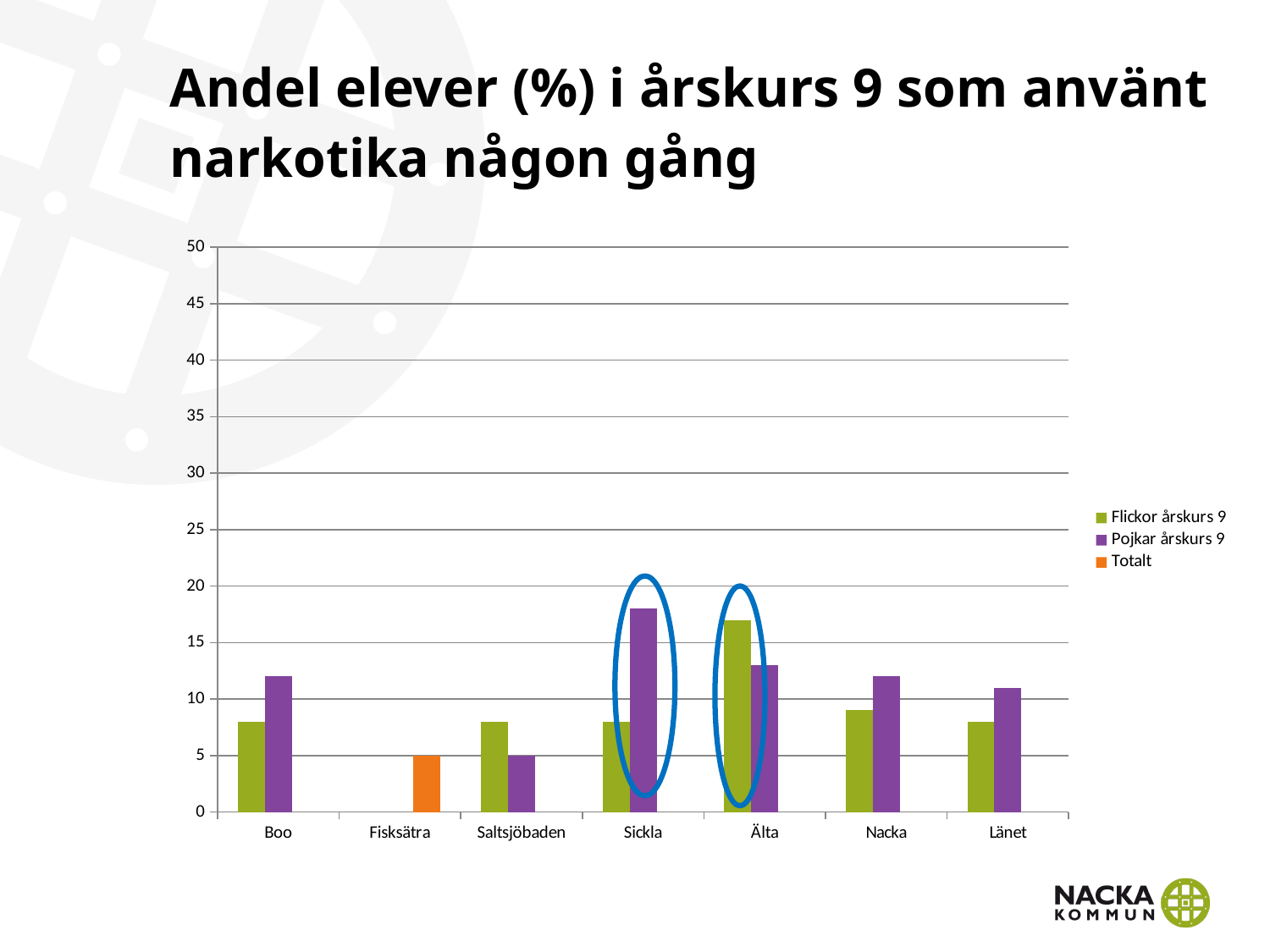
How many categories are shown on the x axis? 7 In Sickla, which is larger: Flickor årskurs 9 or Pojkar årskurs 9? Pojkar årskurs 9 Which category has the highest value for Flickor årskurs 9? Älta Is the value for Pojkar årskurs 9 in Sickla greater or less than 15? greater Is the value for Flickor årskurs 9 in Boo greater or less than 10? less Which category has the lowest value for Pojkar årskurs 9? Saltsjöbaden Which category shows only a Totalt bar? Fisksätra In Älta, which is larger: Flickor årskurs 9 or Pojkar årskurs 9? Flickor årskurs 9 Which category has the highest value for Pojkar årskurs 9? Sickla How many series does the legend list? 3 Is the value for Pojkar årskurs 9 in Nacka greater or less than 10? greater What kind of chart is shown on the slide? bar chart